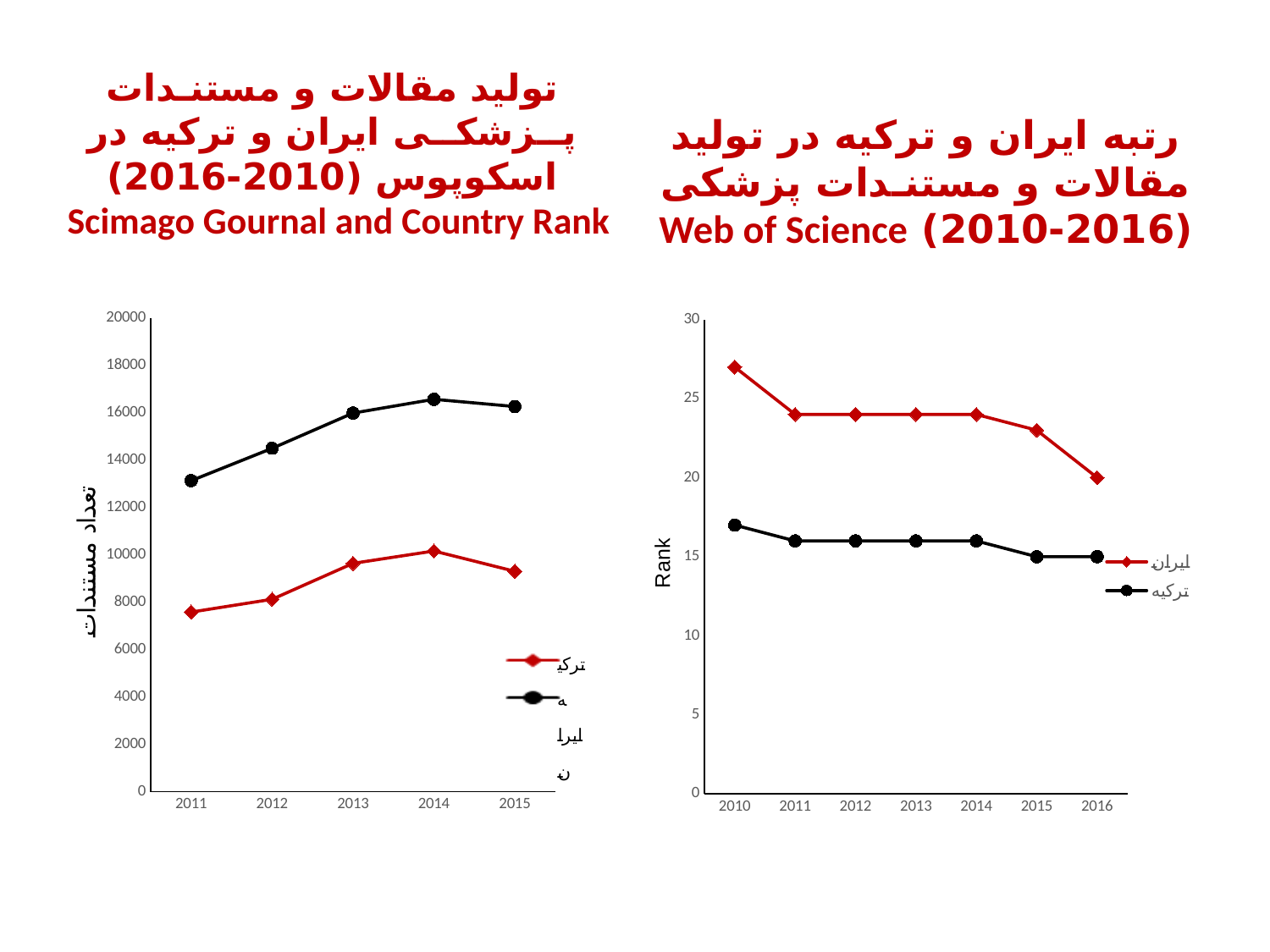
In the right-hand Web of Science chart, is the rank for ایران in 2010 greater or less than 25? greater In the right-hand Web of Science chart, is the rank for ایران in 2016 greater or less than 25? less In the right-hand Web of Science chart, in which year is the rank for ایران highest? 2010 In the right-hand Web of Science chart, does the rank for ایران rise or fall from 2010 to 2016? fall In the left-hand Scimago chart, is the value of the black line with circle markers in 2011 greater or less than 14000? less In the left-hand Scimago chart, how many years are shown on the x axis? 5 In the right-hand Web of Science chart, which series has the higher rank value in 2014, ایران or ترکیه? ایران In the right-hand Web of Science chart, how many years are shown on the x axis? 7 What kind of chart is the right-hand chart titled 'Web of Science (2010-2016)'? line chart In the right-hand Web of Science chart, how many series does the legend list? 2 In the left-hand Scimago chart, in which year does the black line with circle markers reach its highest value? 2014